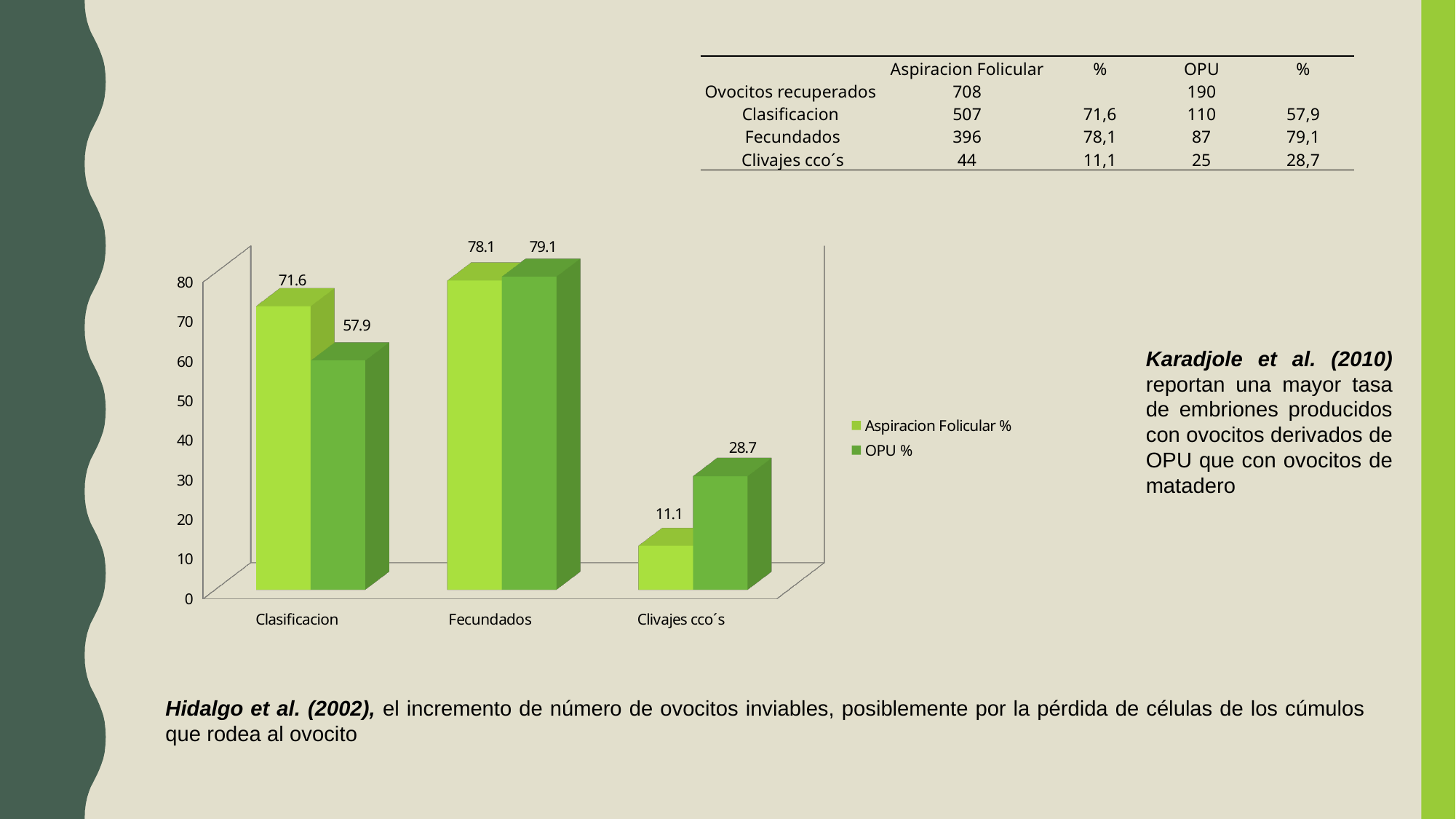
What is the difference between the Aspiracion Folicular % and OPU % values for Clasificacion? 13.7 Which category has the highest OPU % value? Fecundados What is the Aspiracion Folicular % value for Clasificacion? 71.6 How many series does the chart legend list? 2 How many categories are shown on the x axis of the chart? 3 What is the OPU % value for Fecundados? 79.1 What are the two series named in the chart legend? Aspiracion Folicular % and OPU % What is the OPU % value for Clivajes cco´s? 28.7 Which category has the lowest Aspiracion Folicular % value? Clivajes cco´s What is the difference between the OPU % and Aspiracion Folicular % values for Clivajes cco´s? 17.6 For Fecundados, which series has the larger value, Aspiracion Folicular % or OPU %? OPU % What kind of chart is shown on the slide? Bar chart